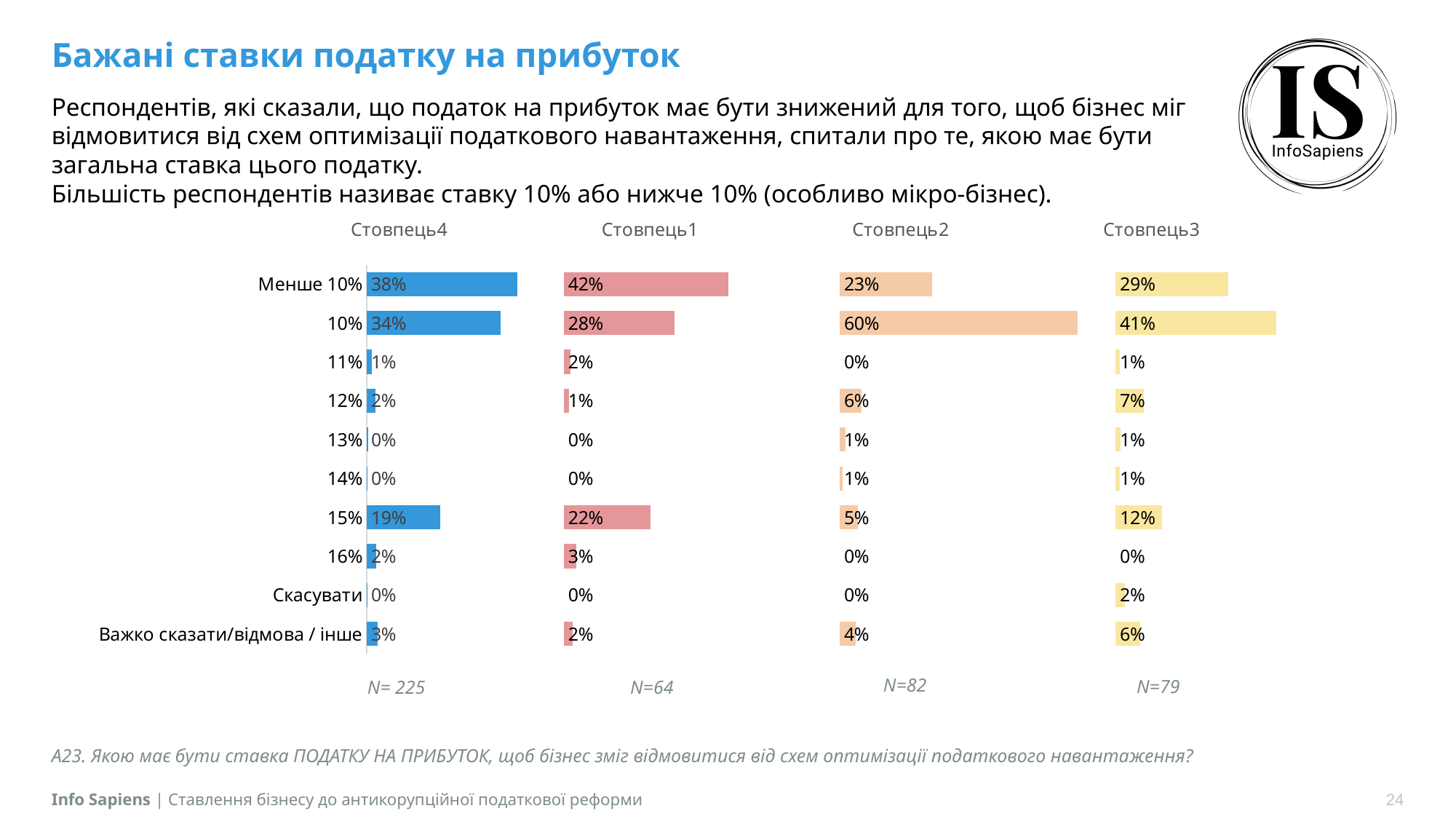
What is the value for "10%" in the Стовпець2 series? 60% Which category has the highest value in the Стовпець4 series? Менше 10% Which category has the highest value in the Стовпець3 series? 10% What kind of chart is shown on the slide? Bar chart Which is larger: the "15%" value in Стовпець4 or the "15%" value in Стовпець1? Стовпець1 What is the value for "15%" in the Стовпець3 series? 12% What sample size (N) is shown under the Стовпець2 series? N=82 How many categories are shown on the vertical axis of the chart? 10 What is the difference between the "Менше 10%" and "10%" values in the Стовпець1 series? 14% How many series (column groups) does the chart show? 4 What is the value for "Важко сказати/відмова / інше" in the Стовпець4 series? 3% What is the value for "Менше 10%" in the Стовпець1 series? 42%